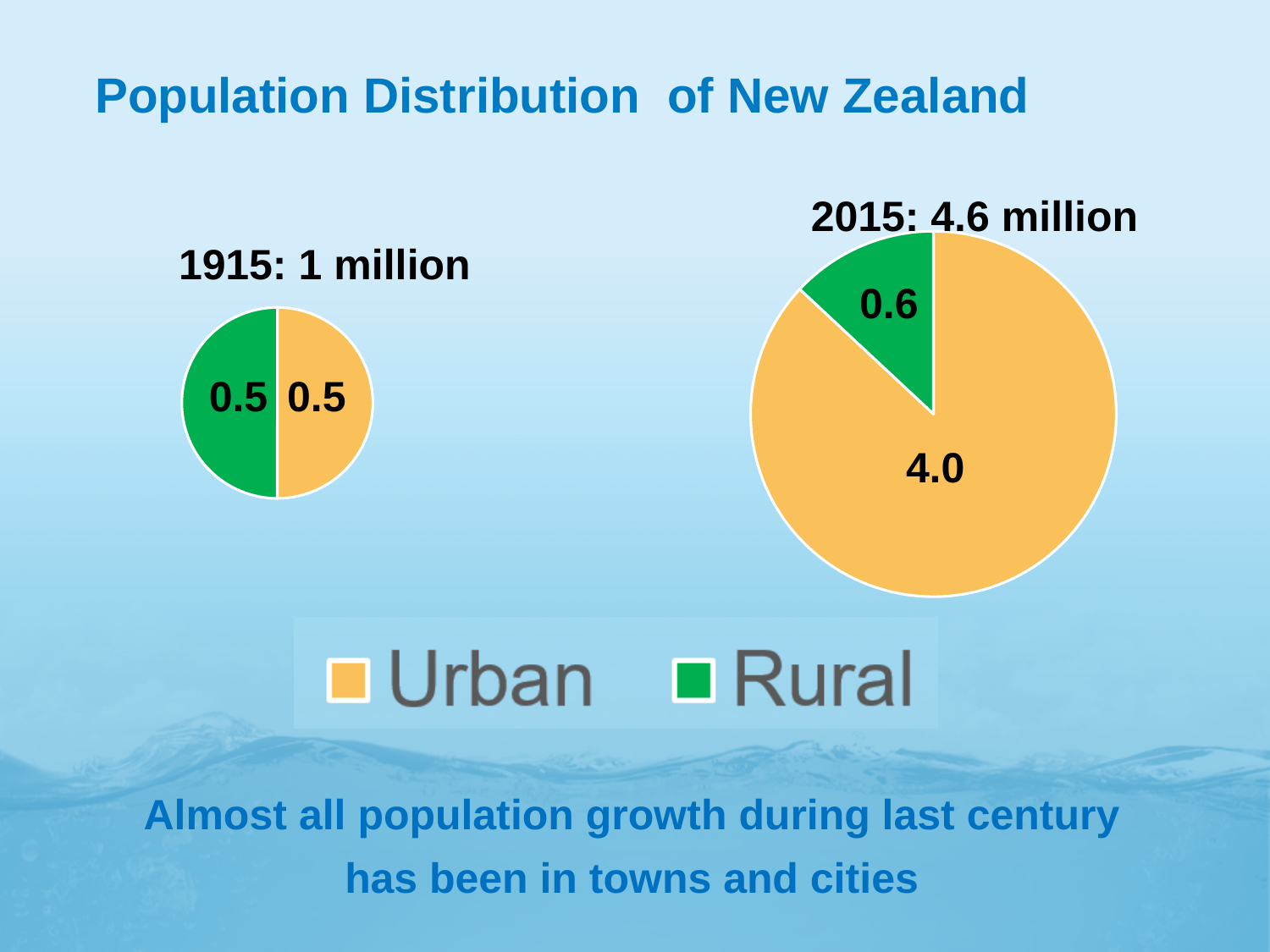
In the 2015 pie chart, what is the value for Urban? 4.0 In the 2015 pie chart, which category has the largest slice? Urban How many series does the legend list? 2 In the 2015 pie chart, which category has the smallest slice? Rural In the 2015 pie chart, what is the difference between the Urban and Rural values? 3.4 In the 2015 pie chart, what is the value for Rural? 0.6 What share of the 1915 pie chart does the Rural slice represent? 50% What kind of charts are shown on the slide? Pie charts In the 1915 pie chart, what is the value for Urban? 0.5 Which colour represents Rural in the legend? Green In the 2015 pie chart, which is larger, Urban or Rural? Urban In the 1915 pie chart, what is the value for Rural? 0.5